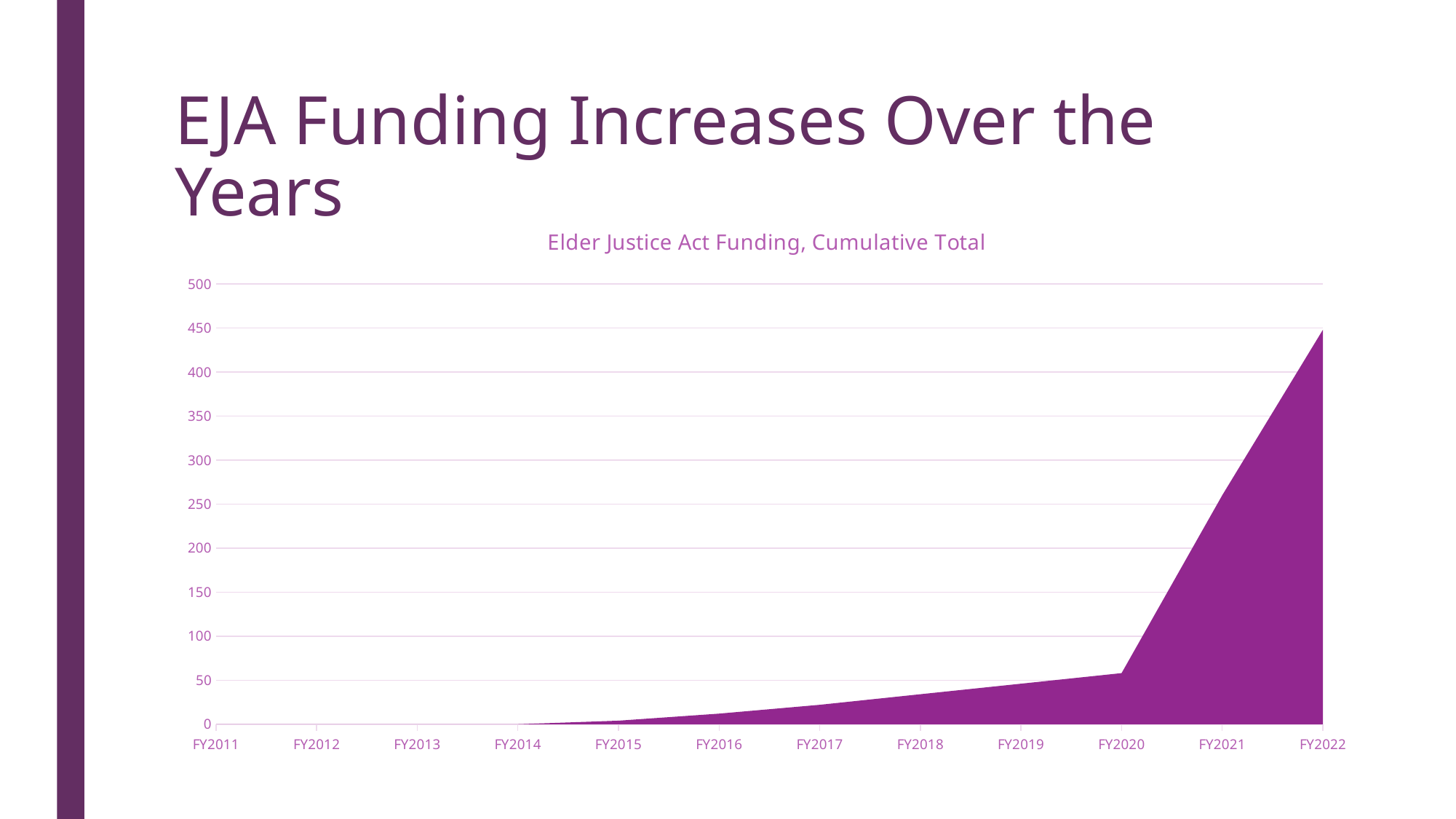
Is the value for FY2020 greater or less than 100? less What kind of chart is shown on the slide? area chart What is the highest value shown on the y axis of the chart? 500 How many fiscal years are shown on the x axis of the chart? 12 Is the value for FY2022 greater or less than 400? greater Which fiscal year has the highest cumulative funding total? FY2022 Is the value for FY2018 greater or less than 50? less Do the values rise or fall from FY2011 to FY2022? rise What is the title of the chart? Elder Justice Act Funding, Cumulative Total Which is larger, the value for FY2021 or the value for FY2022? FY2022 Which is larger, the value for FY2019 or the value for FY2020? FY2020